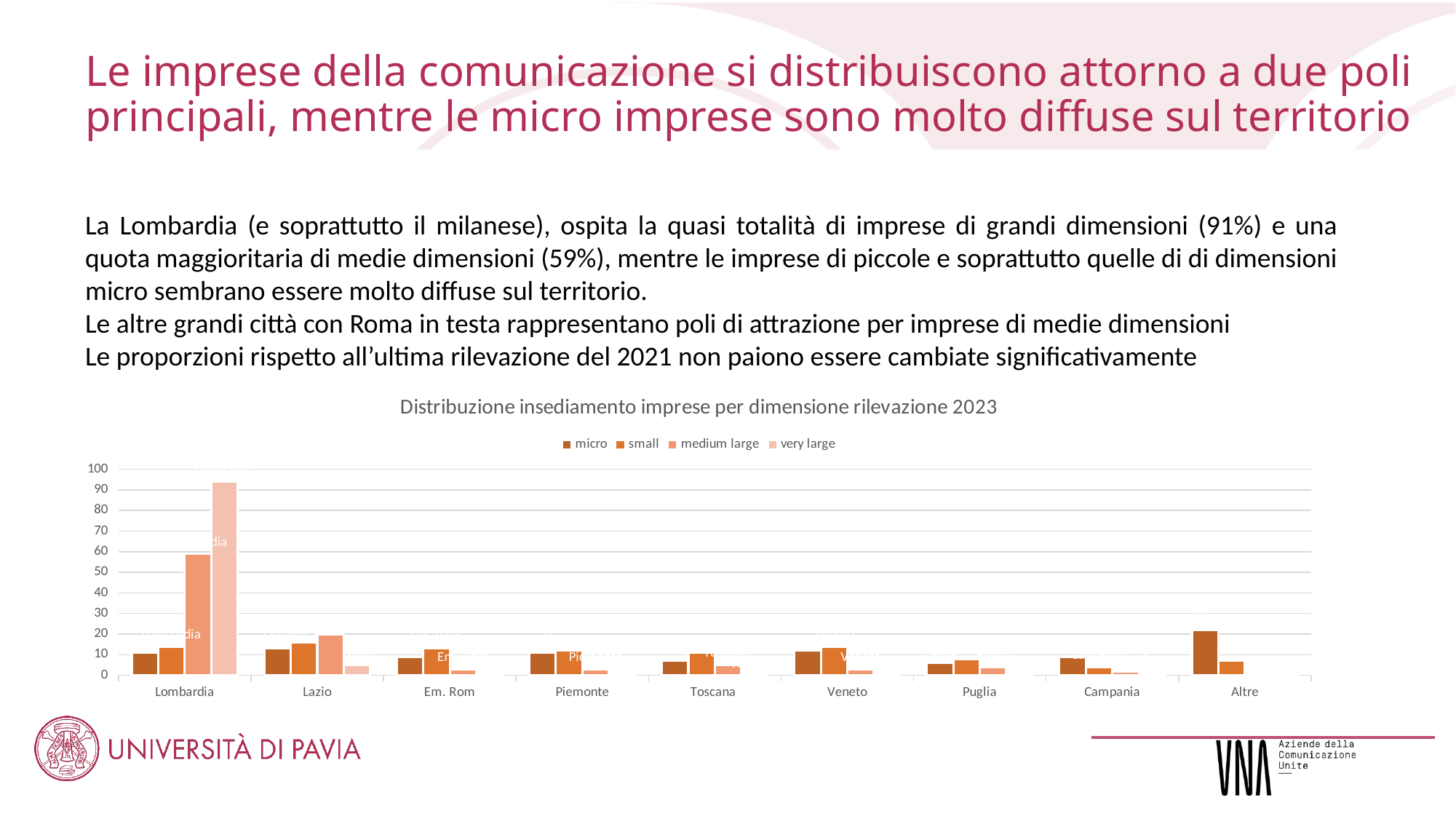
Which region has the highest bar for the 'very large' series? Lombardia Is the 'very large' value for Lombardia greater or less than 80? greater Is the 'micro' value for Altre greater or less than 15? greater For Lazio, which is larger: the 'medium large' bar or the 'very large' bar? medium large For Lombardia, which is larger: the 'very large' bar or the 'medium large' bar? very large Which region has the highest bar for the 'micro' series? Altre Is the 'medium large' value for Lombardia greater or less than 50? greater How many series does the chart legend list? 4 What is the title of the chart? Distribuzione insediamento imprese per dimensione rilevazione 2023 How many regions (categories) are shown on the x axis of the chart? 9 What kind of chart is shown on the slide? bar chart